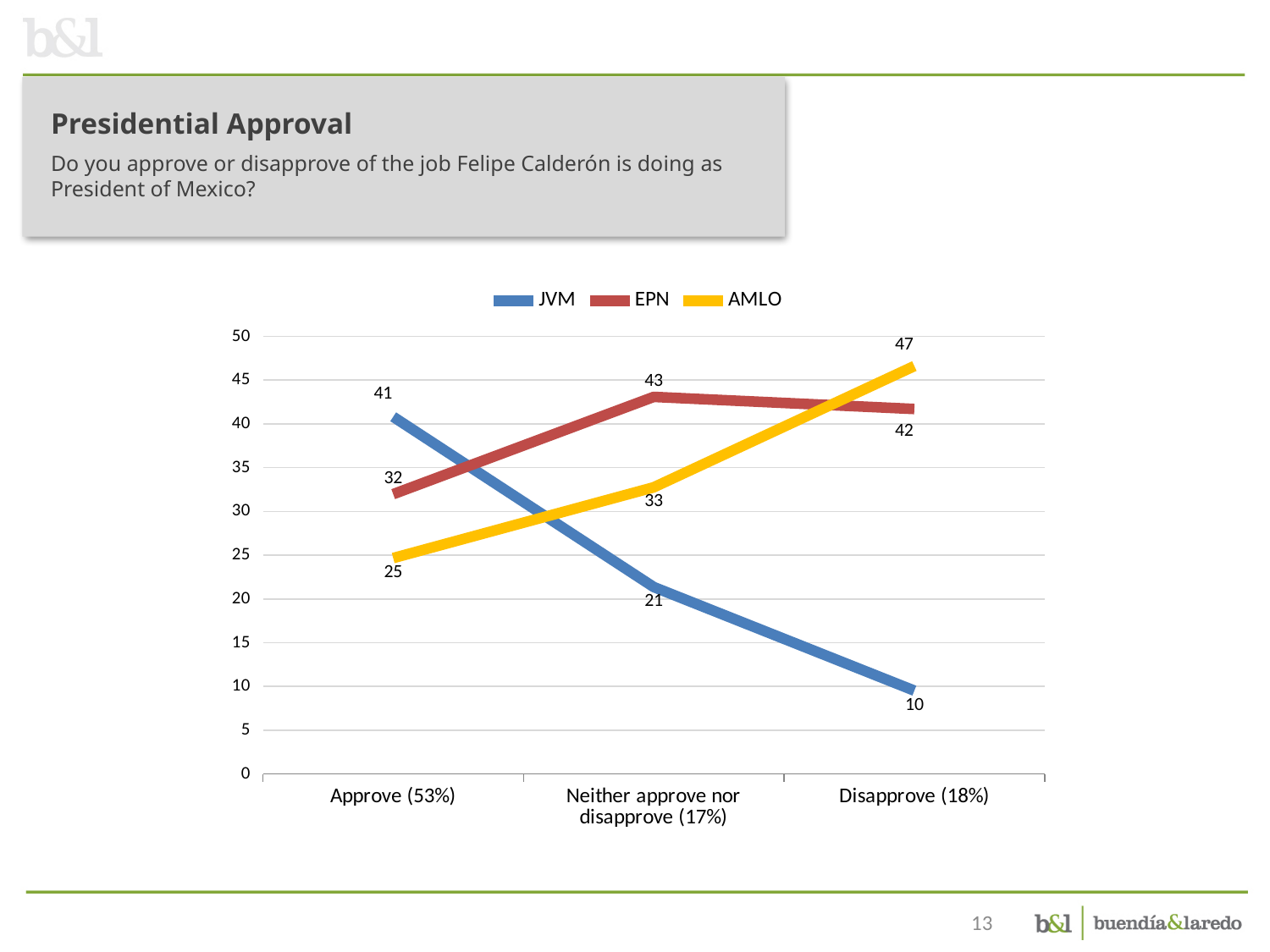
Which colour is used for the AMLO series? Yellow Which category has the highest value for AMLO? Disapprove (18%) What is the difference between the EPN and AMLO values among respondents who Approve (53%)? 7 Does the JVM line rise or fall from Approve (53%) to Disapprove (18%)? Fall What is the value for AMLO among respondents who Disapprove (18%)? 47 Which category has the lowest value for JVM? Disapprove (18%) How many series does the legend list? 3 What is the value for JVM among respondents who Approve (53%)? 41 What kind of chart is shown on the slide? Line chart Among respondents who Neither approve nor disapprove (17%), which series has the larger value, EPN or AMLO? EPN What is the value for EPN among respondents who Neither approve nor disapprove (17%)? 43 How many categories are shown on the x axis? 3